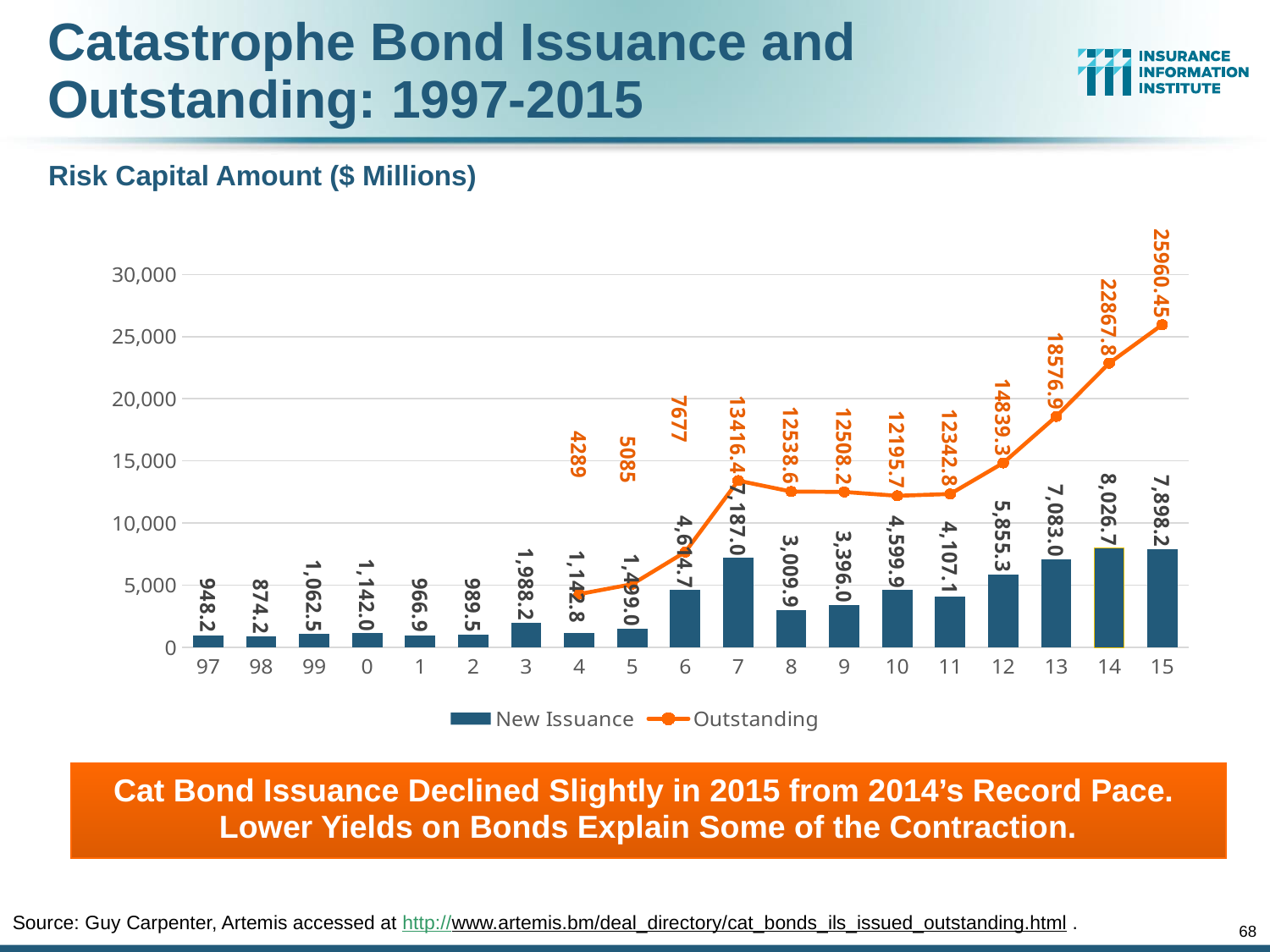
What is the Outstanding value for 7? 13416.4 Is the Outstanding value for 13 greater or less than 15,000? greater How many series does the legend list? 2 Does the Outstanding line rise or fall from 12 to 15? Rises Which is larger, the Outstanding value for 7 or for 8? 7 Which year has the highest New Issuance value? 14 Which year has the lowest New Issuance value? 98 What is the difference between the New Issuance values for 14 and 15? 128.5 What is the New Issuance value for 14? 8,026.7 What kind of chart is shown on the slide? Combination bar and line chart What is the Outstanding value for 15? 25960.45 How many years are shown on the x axis? 19